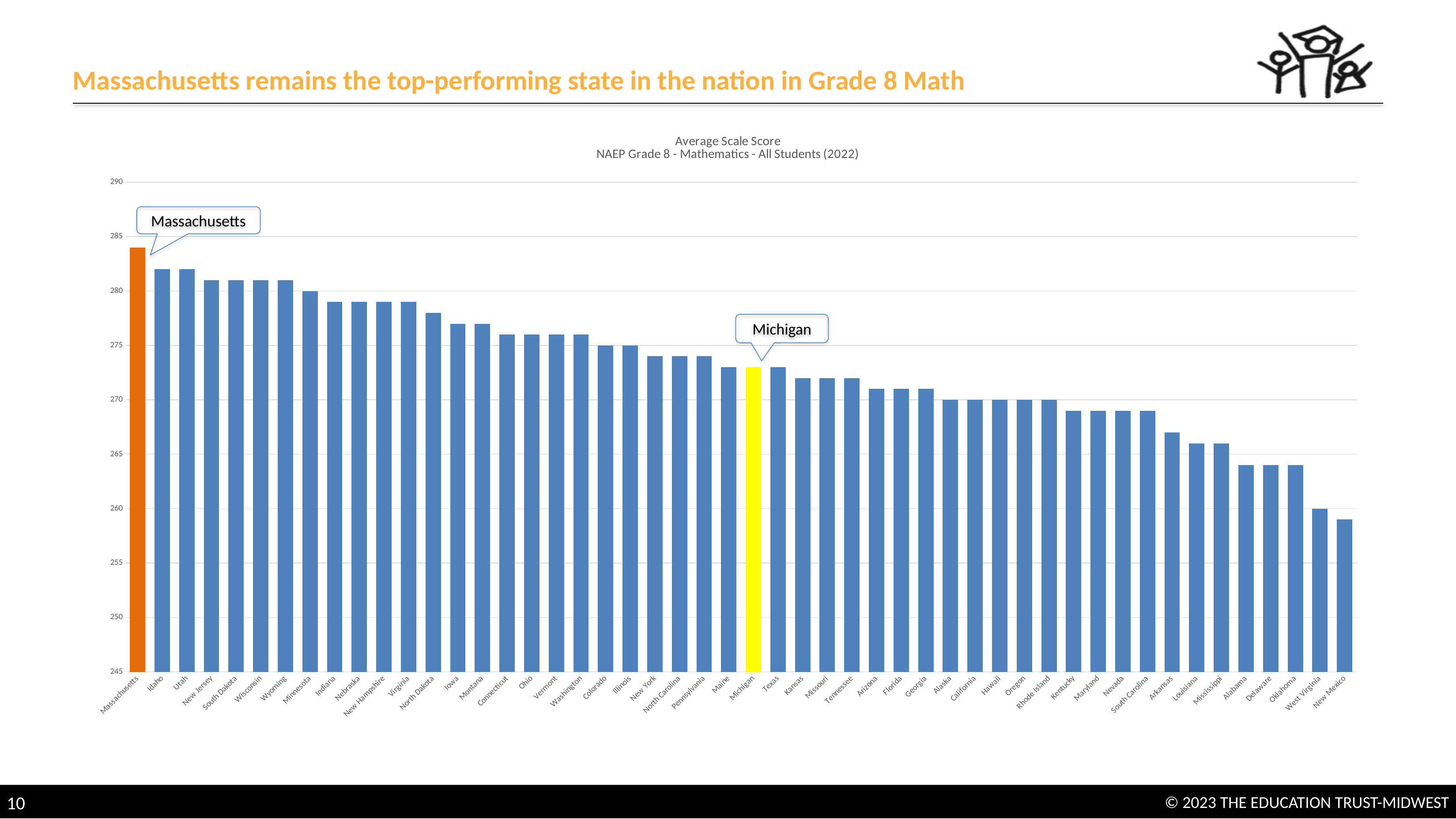
Which state has the lowest average scale score in the chart? New Mexico Is the value for Massachusetts greater or less than 280? greater Do the values rise or fall moving from left to right across the chart? Fall What colour is the bar for Michigan? Yellow What kind of chart is shown on the slide? Bar chart How many states are plotted in the chart? 50 Is the value for New Mexico greater or less than 265? less Is the value for Michigan greater or less than 275? less Which has a higher average scale score, Massachusetts or Michigan? Massachusetts Which state has the highest average scale score in the chart? Massachusetts